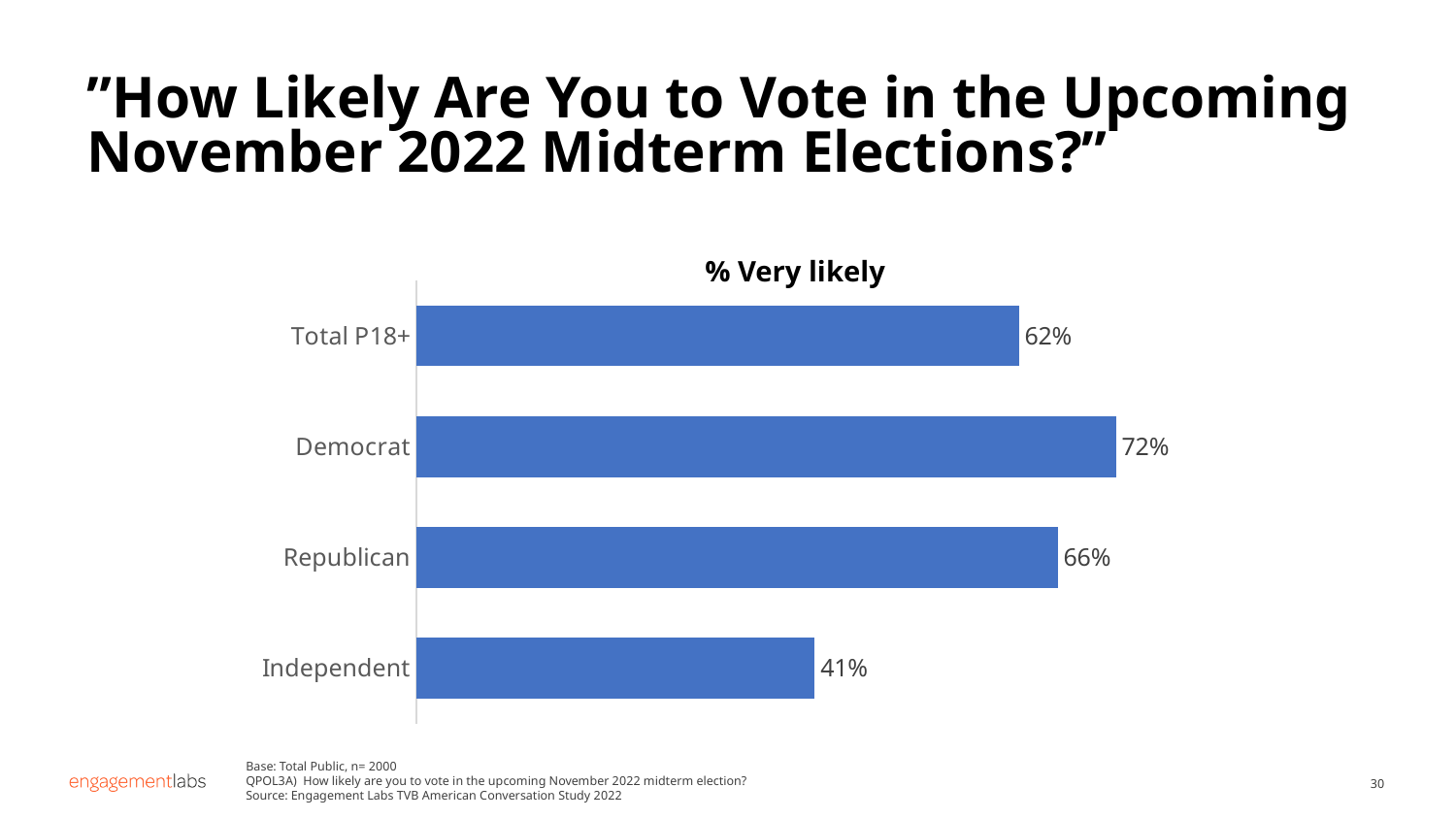
Which category has the lowest value? Independent How many categories are shown in the chart? 4 What kind of chart is shown on the slide? Bar chart What is the difference between the Democrat and Republican values? 6% What is the value for Total P18+? 62% What is the title of the chart? % Very likely Which category has the highest value? Democrat What is the value for Democrat? 72% What is the value for Independent? 41% What is the value for Republican? 66% Which is larger, the value for Republican or the value for Total P18+? Republican What is the difference between the Republican and Independent values? 25%